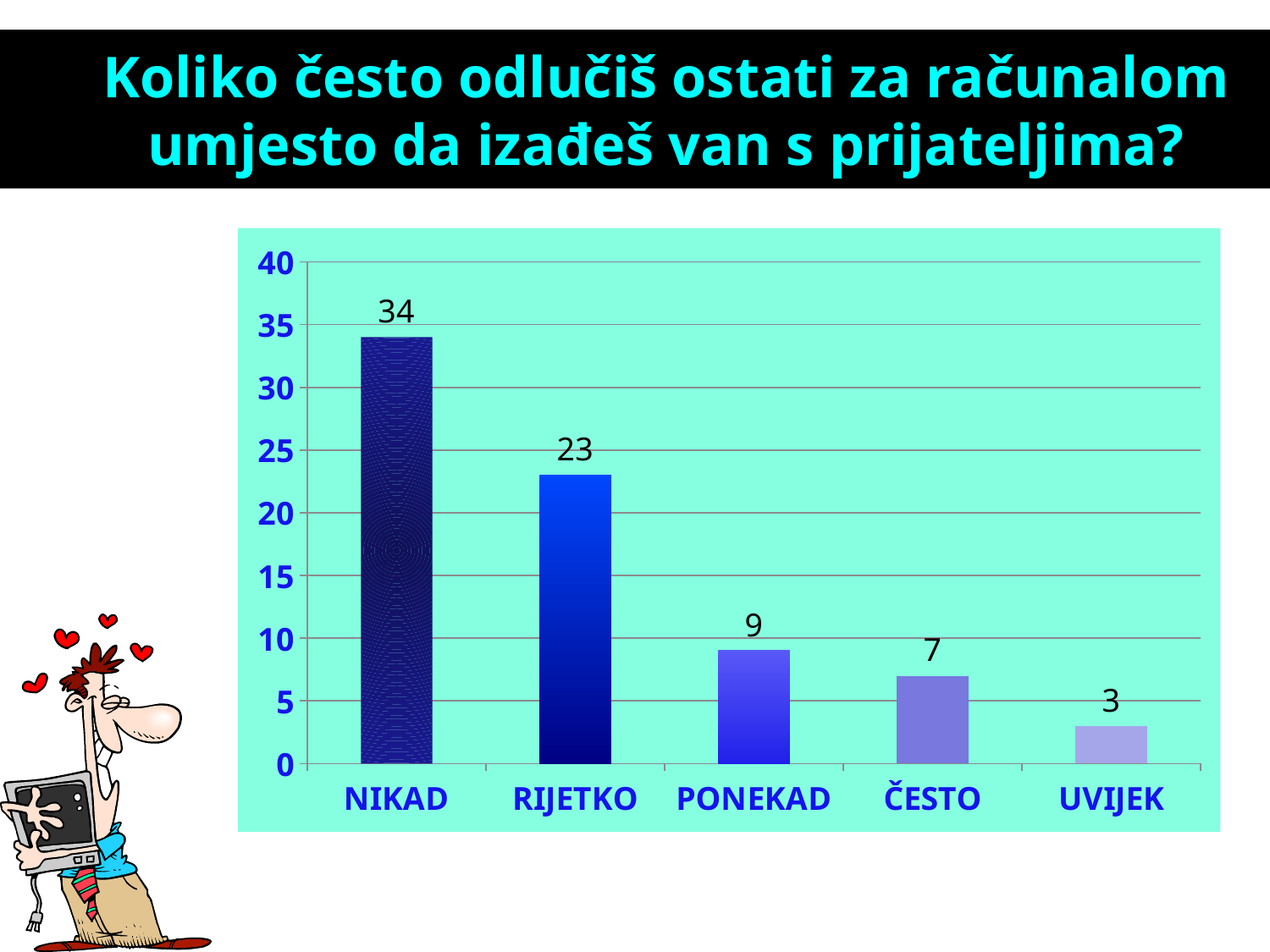
Which is larger, the value for ČESTO or the value for UVIJEK? ČESTO What is the value for UVIJEK? 3 What is the value for PONEKAD? 9 What is the difference between the values for PONEKAD and ČESTO? 2 Do the values rise or fall from NIKAD to UVIJEK along the x axis? Fall What is the value for RIJETKO? 23 What is the value for NIKAD? 34 What kind of chart is shown on the slide? Bar chart Which category has the lowest value? UVIJEK Which category has the highest value? NIKAD How many categories are shown on the x axis? 5 What is the difference between the values for NIKAD and RIJETKO? 11